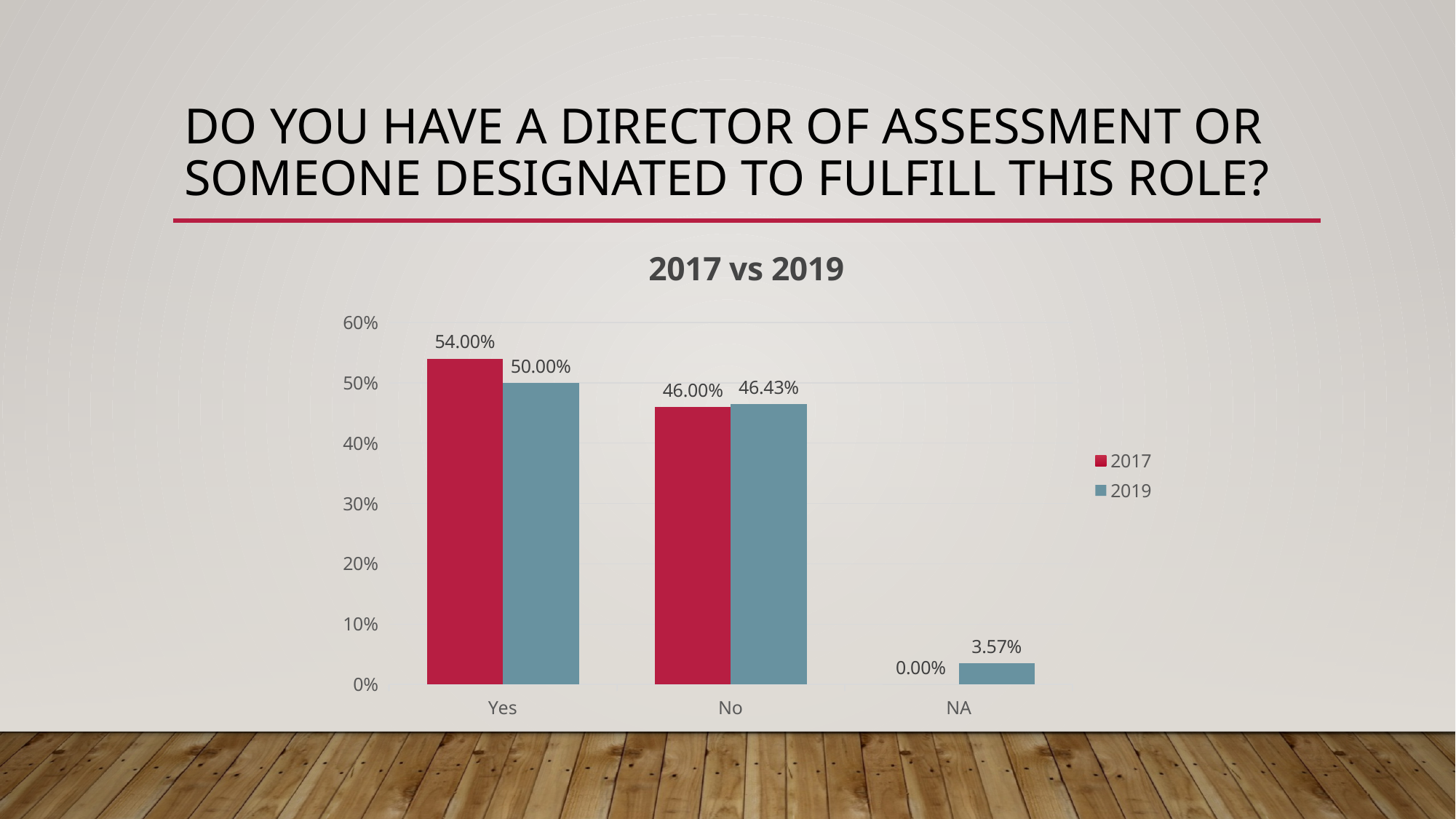
How many categories are shown on the x axis? 3 What kind of chart is shown on the slide? Bar chart What is the 2017 value for Yes? 54.00% What is the difference between the 2017 and 2019 values for Yes? 4.00% What is the title of the chart? 2017 vs 2019 Which category has the lowest 2017 value? NA Which is larger for Yes, the 2017 value or the 2019 value? 2017 What is the 2019 value for NA? 3.57% What is the 2019 value for No? 46.43% How many series does the legend list? 2 Which category has the highest 2019 value? Yes What is the 2017 value for NA? 0.00%